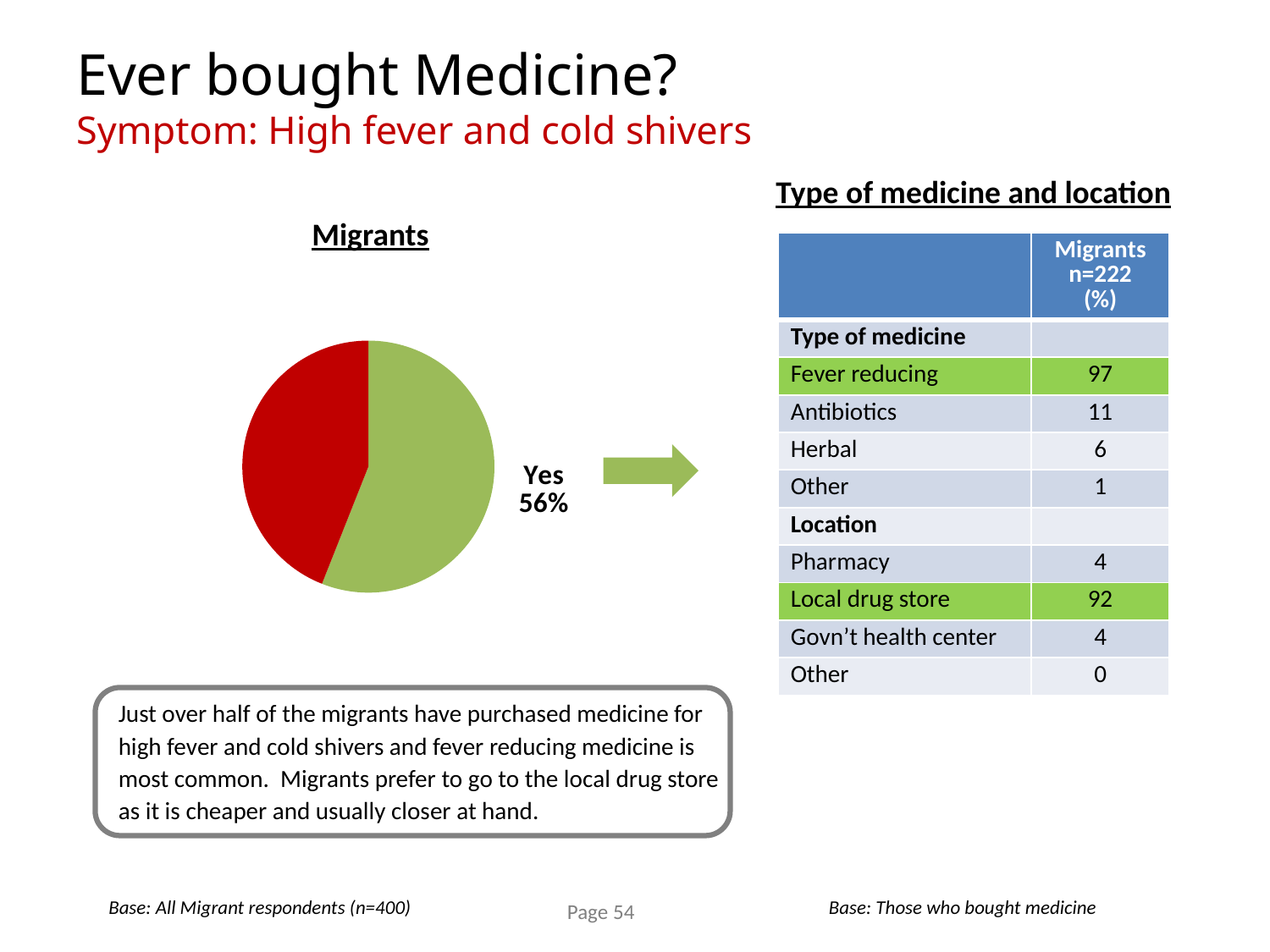
What colour is the "Yes" slice in the Migrants pie chart? green In the Migrants pie chart, what share of migrants answered "Yes" to having bought medicine? 56% In the Migrants pie chart, which slice is larger: the green "Yes" slice or the red slice? the green "Yes" slice What kind of chart is shown under the heading "Migrants"? pie chart What is the title printed above the pie chart? Migrants Which slice is the largest in the Migrants pie chart? Yes How many slices does the Migrants pie chart have? 2 What is the value printed for the "Yes" slice in the Migrants pie chart? 56% In the Migrants pie chart, is the "Yes" slice greater or less than 50%? greater